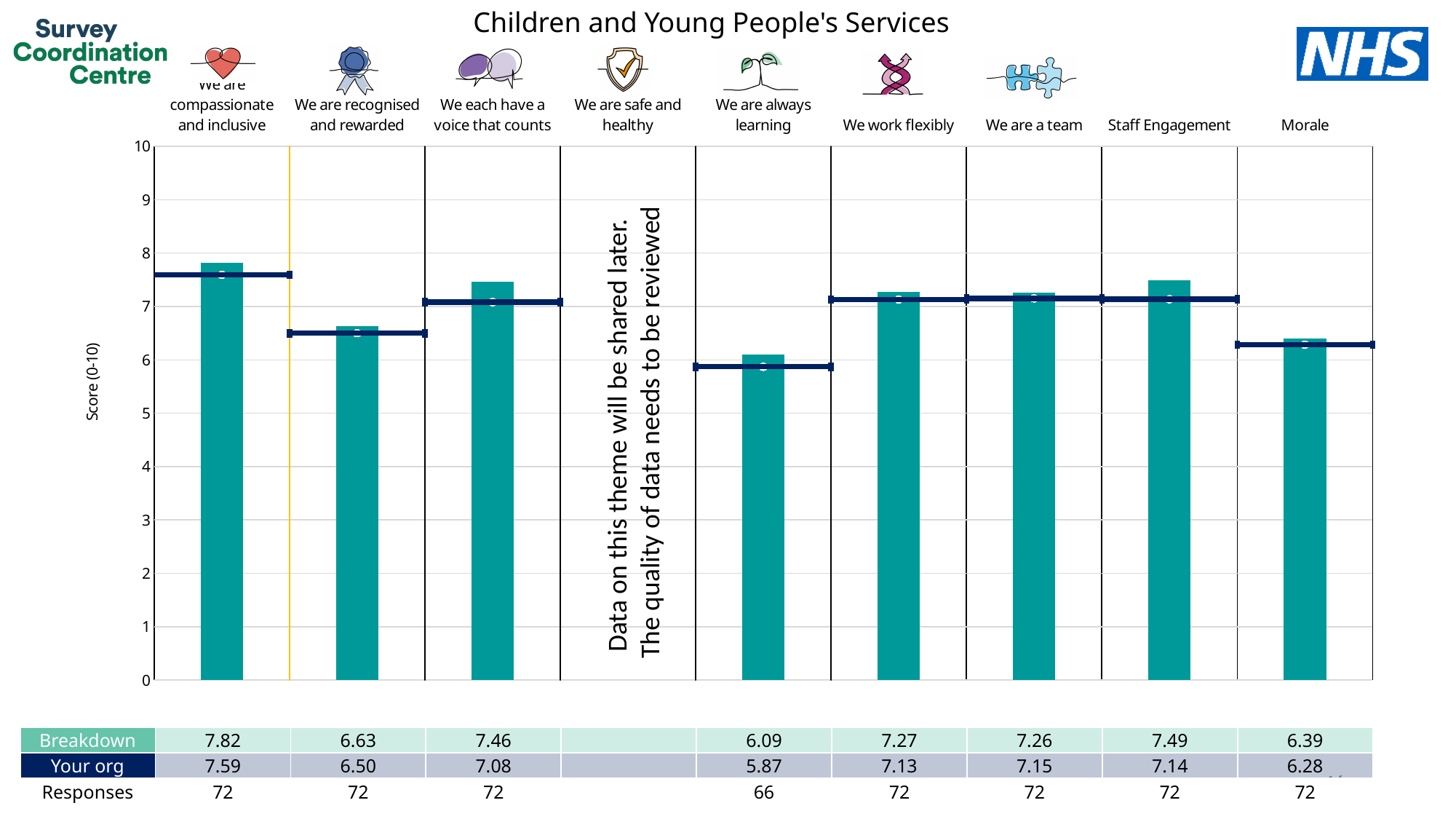
Which theme has no data shown on the chart? We are safe and healthy Which theme has the lowest Breakdown score? We are always learning What is the title of the chart? Children and Young People's Services What is the Your org score for 'We are always learning'? 5.87 How many themes have a bar plotted on the chart? 8 How many responses are recorded for 'We are always learning'? 66 What kind of chart is shown on the slide? bar chart Which has the higher Breakdown score, Staff Engagement or Morale? Staff Engagement Which theme has the highest Breakdown score? We are compassionate and inclusive Is the Breakdown bar for Morale greater or less than 7? less What is the Breakdown score for 'We are compassionate and inclusive'? 7.82 What is the difference between the Breakdown and Your org scores for 'We are compassionate and inclusive'? 0.23